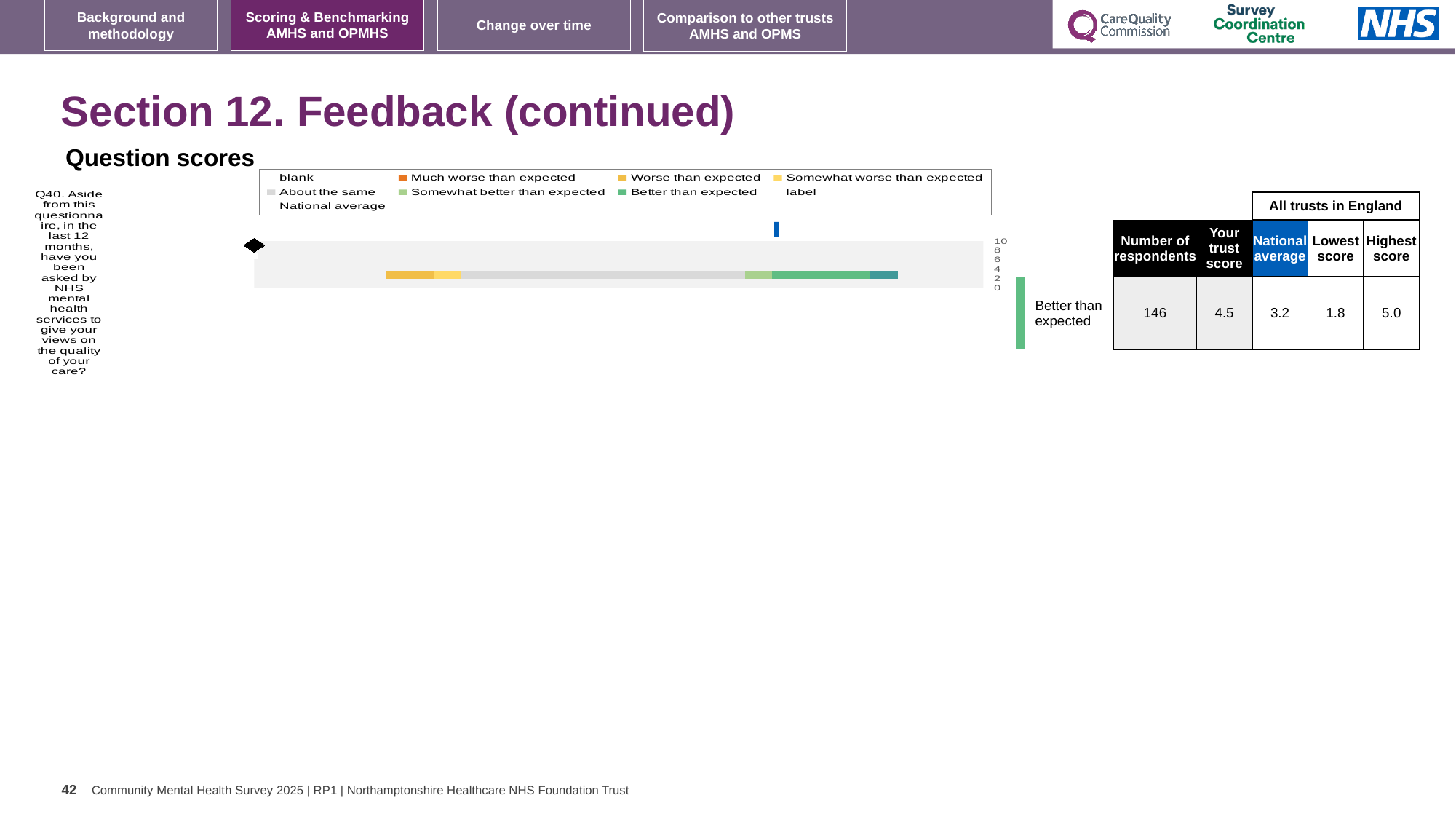
In the 'Question scores' chart legend, what colour represents 'Better than expected'? green In the table next to the 'Question scores' chart, what is the lowest score among all trusts in England for Q40? 1.8 How many survey questions are plotted in the 'Question scores' chart? 1 In the table next to the 'Question scores' chart, what is the highest score among all trusts in England for Q40? 5.0 In the table next to the 'Question scores' chart, what is 'Your trust score' for Q40? 4.5 What kind of chart is shown under 'Question scores'? bar chart In the table next to the 'Question scores' chart, what is the number of respondents for Q40? 146 In the table next to the 'Question scores' chart, what is the national average for Q40? 3.2 For Q40, is 'Your trust score' larger or smaller than the national average? larger According to the label beside the 'Question scores' chart, which category does the trust's score for Q40 fall into? Better than expected For Q40, what is the difference between 'Your trust score' and the national average? 1.3 Which question is plotted in the 'Question scores' chart? Q40